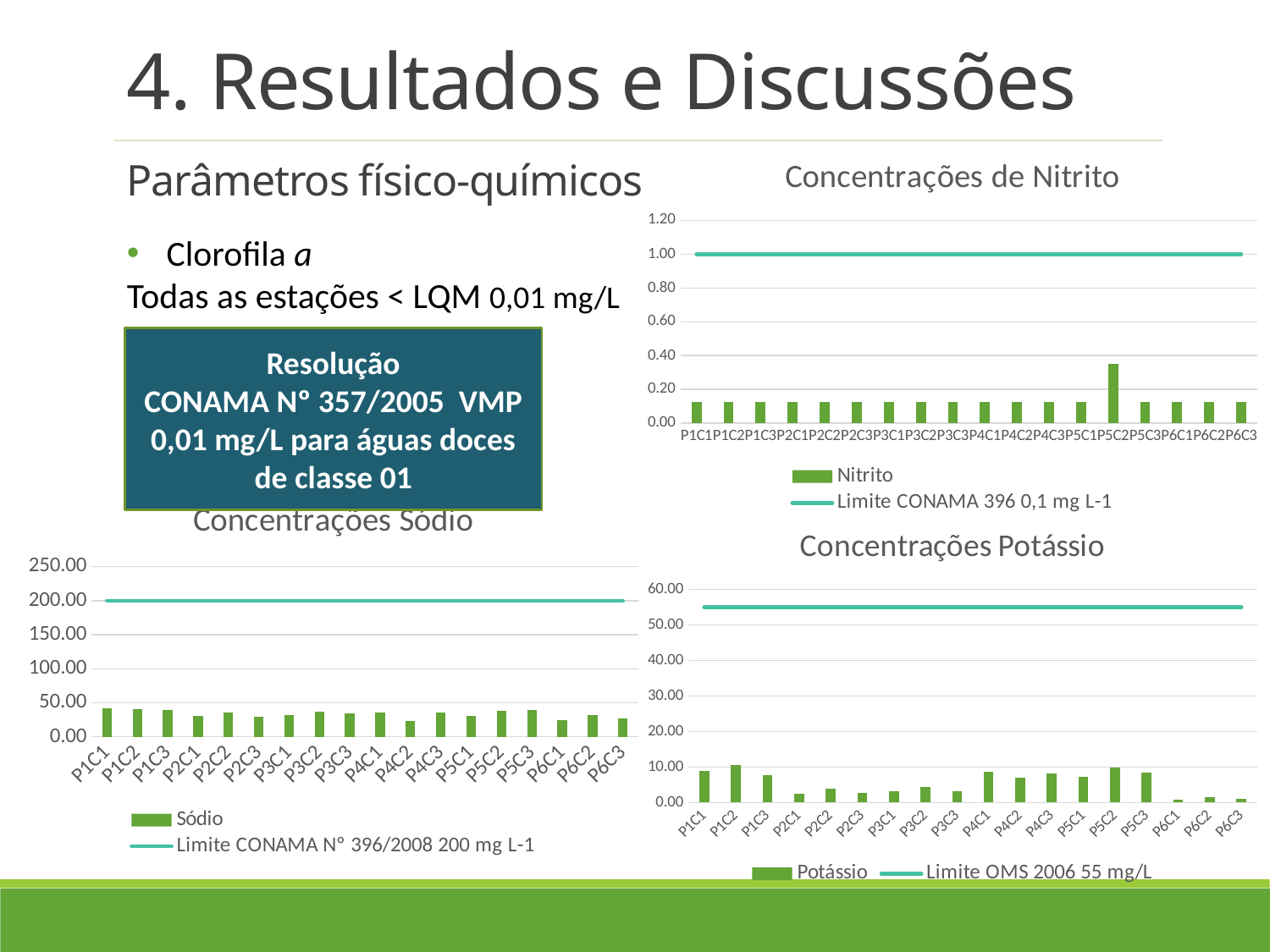
In the 'Concentrações Potássio' chart, which is larger, the value for P1C2 or the value for P6C1? P1C2 What are the two legend entries of the 'Concentrações Potássio' chart? Potássio; Limite OMS 2006 55 mg/L In the 'Concentrações Sódio' chart, is the value for P1C1 greater or less than 50.00? less In the 'Concentrações Potássio' chart, is the value for P2C1 greater or less than 10.00? less In the 'Concentrações Sódio' chart, which is larger, the value for P1C1 or the value for P4C2? P1C1 In the 'Concentrações de Nitrito' chart, which station has the highest nitrite value? P5C2 How many stations are shown on the x axis of the 'Concentrações de Nitrito' chart? 18 In the 'Concentrações Sódio' chart, at what value does the 'Limite CONAMA N° 396/2008' line sit? 200.00 In the 'Concentrações de Nitrito' chart, is the value for P5C2 greater or less than 0.20? greater In the 'Concentrações de Nitrito' chart, at what value does the 'Limite CONAMA 396' line sit? 1.00 What kind of chart is the 'Concentrações de Nitrito' chart? combination bar and line chart How many entries does the legend of the 'Concentrações de Nitrito' chart list? 2